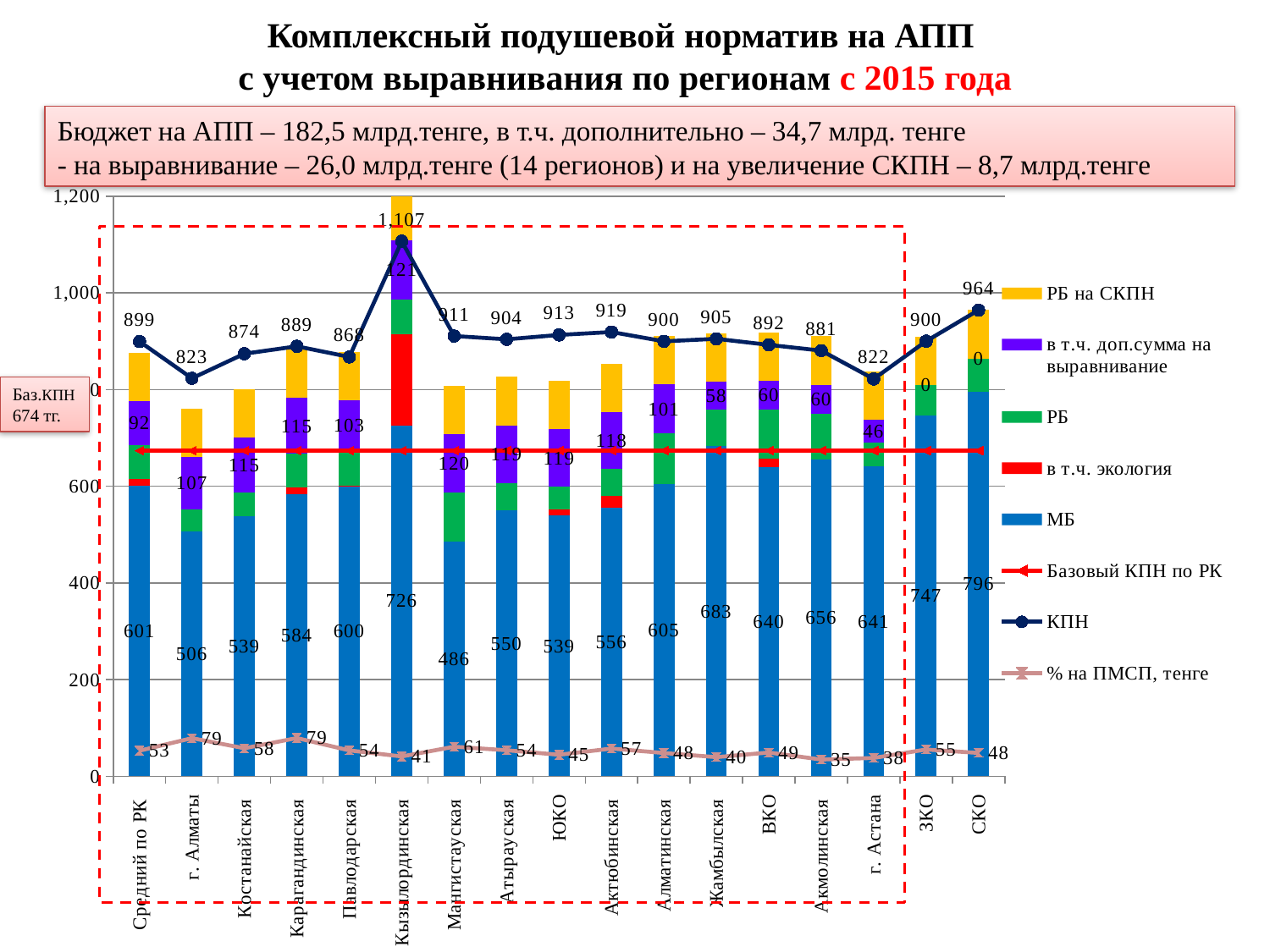
Which region has the highest КПН value? Кызылординская How many series does the legend list? 8 What is the 'в т.ч. доп.сумма на выравнивание' value for г. Астана? 46 Is the total height of the stacked bar for Кызылординская greater or less than 1,000? greater What is the difference between the КПН value for Кызылординская and the КПН value for Средний по РК? 208 What is the КПН value for Кызылординская? 1,107 Which has the larger МБ value, ЗКО or ВКО? ЗКО How many regions (categories) are shown on the x axis? 17 What kind of chart is shown on the slide? stacked bar chart with line series Which region has the lowest МБ value? Мангистауская What is the % на ПМСП value for Акмолинская? 35 What is the МБ value for СКО? 796